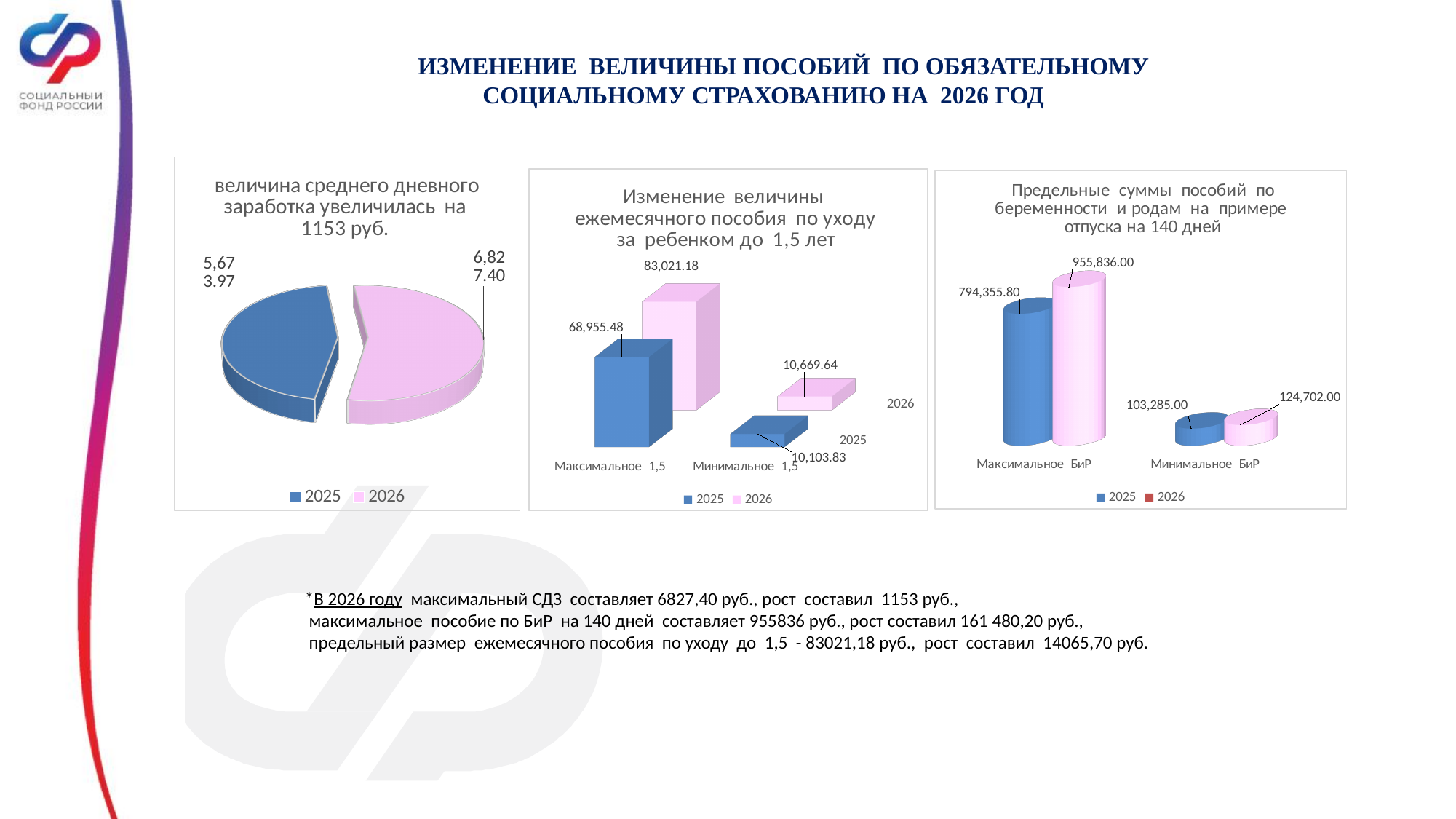
In the right chart (Предельные суммы пособий по беременности и родам), which is larger: Минимальное БиР in 2025 or in 2026? 2026 How many series does the legend of the middle chart list? 2 In the right chart (Предельные суммы пособий по беременности и родам), which category has the highest value? Максимальное БиР (2026) In the middle chart (Изменение величины ежемесячного пособия по уходу за ребенком до 1,5 лет), what is the value for Максимальное 1,5 in 2026? 83,021.18 In the middle chart (Изменение величины ежемесячного пособия по уходу за ребенком до 1,5 лет), what is the difference between the 2026 and 2025 values for Максимальное 1,5? 14,065.70 In the right chart (Предельные суммы пособий по беременности и родам), what is the value for Максимальное БиР in 2026? 955,836.00 How many categories are shown on the x axis of the right chart (Предельные суммы пособий по беременности и родам)? 2 What kind of chart is the left chart (величина среднего дневного заработка)? Pie chart In the right chart (Предельные суммы пособий по беременности и родам), what is the value for Минимальное БиР in 2025? 103,285.00 In the middle chart (Изменение величины ежемесячного пособия по уходу за ребенком до 1,5 лет), what is the value for Максимальное 1,5 in 2025? 68,955.48 In the right chart (Предельные суммы пособий по беременности и родам), what is the difference between the 2026 and 2025 values for Максимальное БиР? 161,480.20 In the middle chart (Изменение величины ежемесячного пособия по уходу за ребенком до 1,5 лет), what is the value for Минимальное 1,5 in 2026? 10,669.64